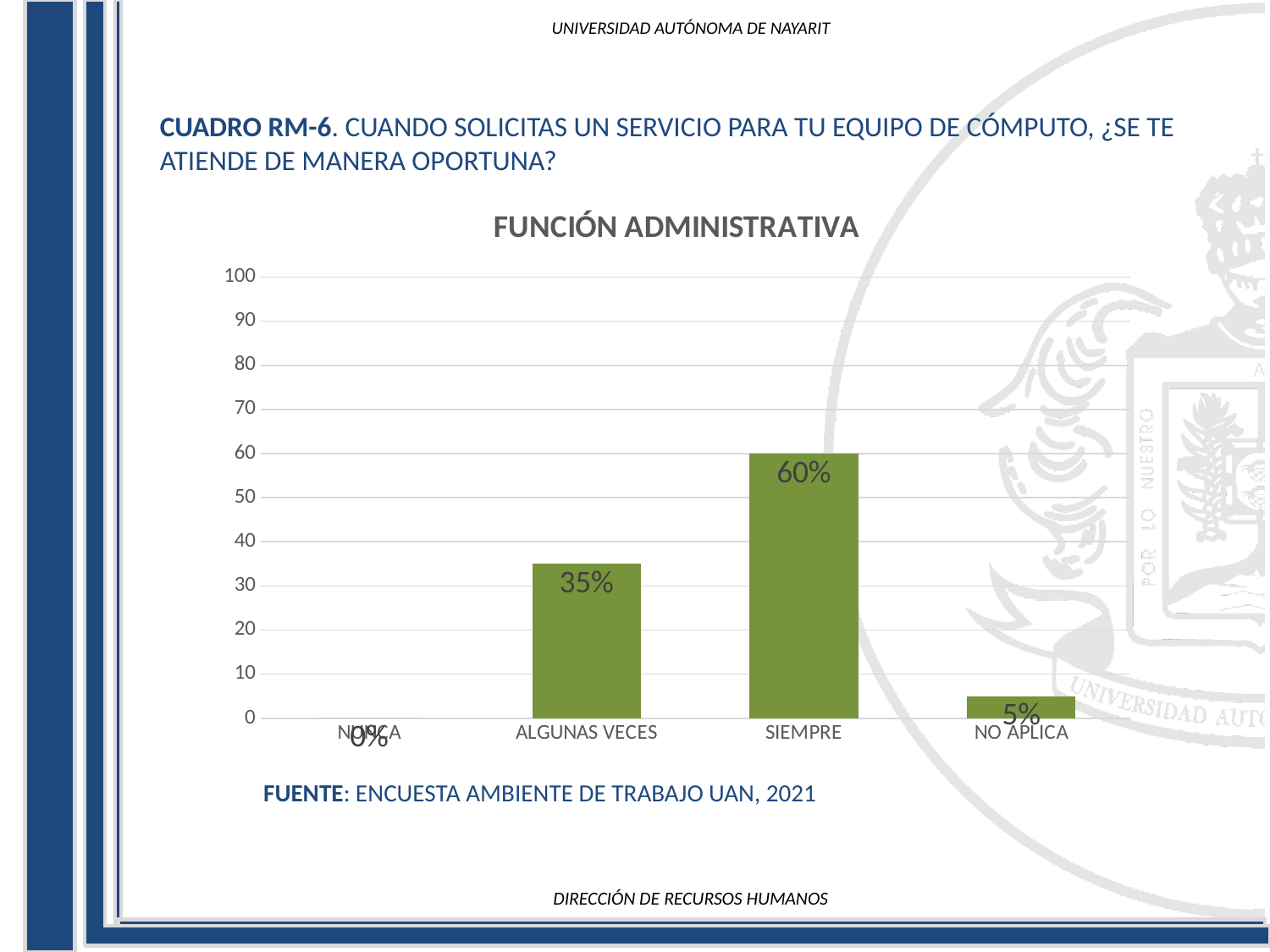
What is the value for NO APLICA? 5% What is the value for NUNCA? 0% What is the title of the chart? FUNCIÓN ADMINISTRATIVA What is the difference between the values for SIEMPRE and ALGUNAS VECES? 25% What kind of chart is shown? bar chart What is the value for ALGUNAS VECES? 35% Which is larger, the value for ALGUNAS VECES or the value for NO APLICA? ALGUNAS VECES Is the value for SIEMPRE greater or less than 50? greater What is the value for SIEMPRE? 60% How many categories are shown on the x axis? 4 Which category has the highest value? SIEMPRE Which category has the lowest value? NUNCA